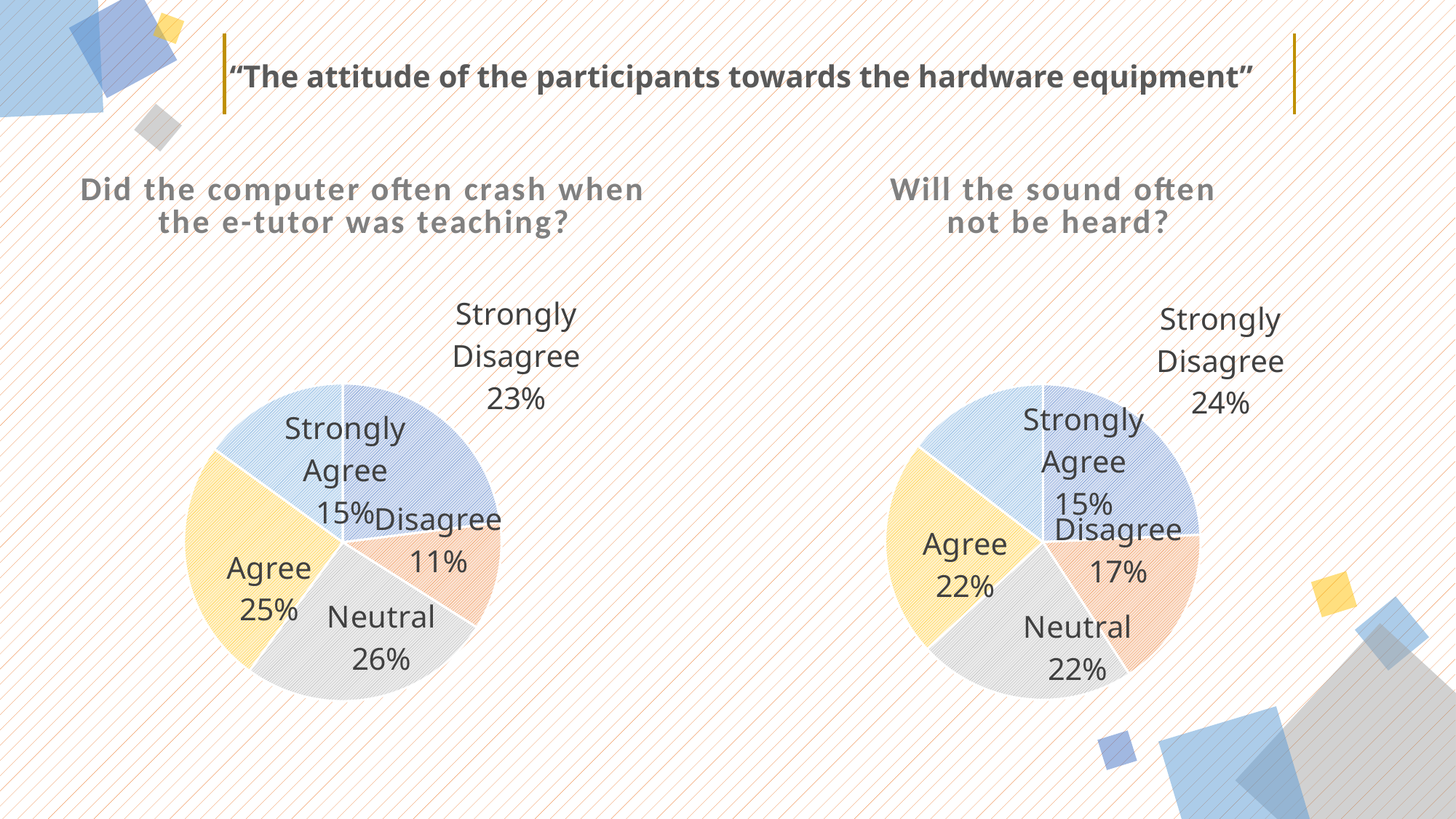
In the chart 'Will the sound often not be heard?', what share of participants answered Strongly Disagree? 24% In the chart 'Will the sound often not be heard?', which response has the largest share? Strongly Disagree In the chart 'Did the computer often crash when the e-tutor was teaching?', which response has the smallest share? Disagree In the chart 'Did the computer often crash when the e-tutor was teaching?', what share of participants answered Neutral? 26% How many response categories does each pie chart show? 5 Which is larger: the Disagree share in the left chart or the Disagree share in the right chart? The right chart (Will the sound often not be heard?) In the chart 'Will the sound often not be heard?', which response has the smallest share? Strongly Agree In the chart 'Did the computer often crash when the e-tutor was teaching?', what share of participants answered Disagree? 11% In the chart 'Will the sound often not be heard?', what share of participants answered Disagree? 17% In the chart 'Will the sound often not be heard?', what is the difference between the Strongly Disagree and Disagree shares? 7% In the chart 'Did the computer often crash when the e-tutor was teaching?', what is the difference between the Agree and Strongly Agree shares? 10% What type of charts are shown on the slide? Pie charts